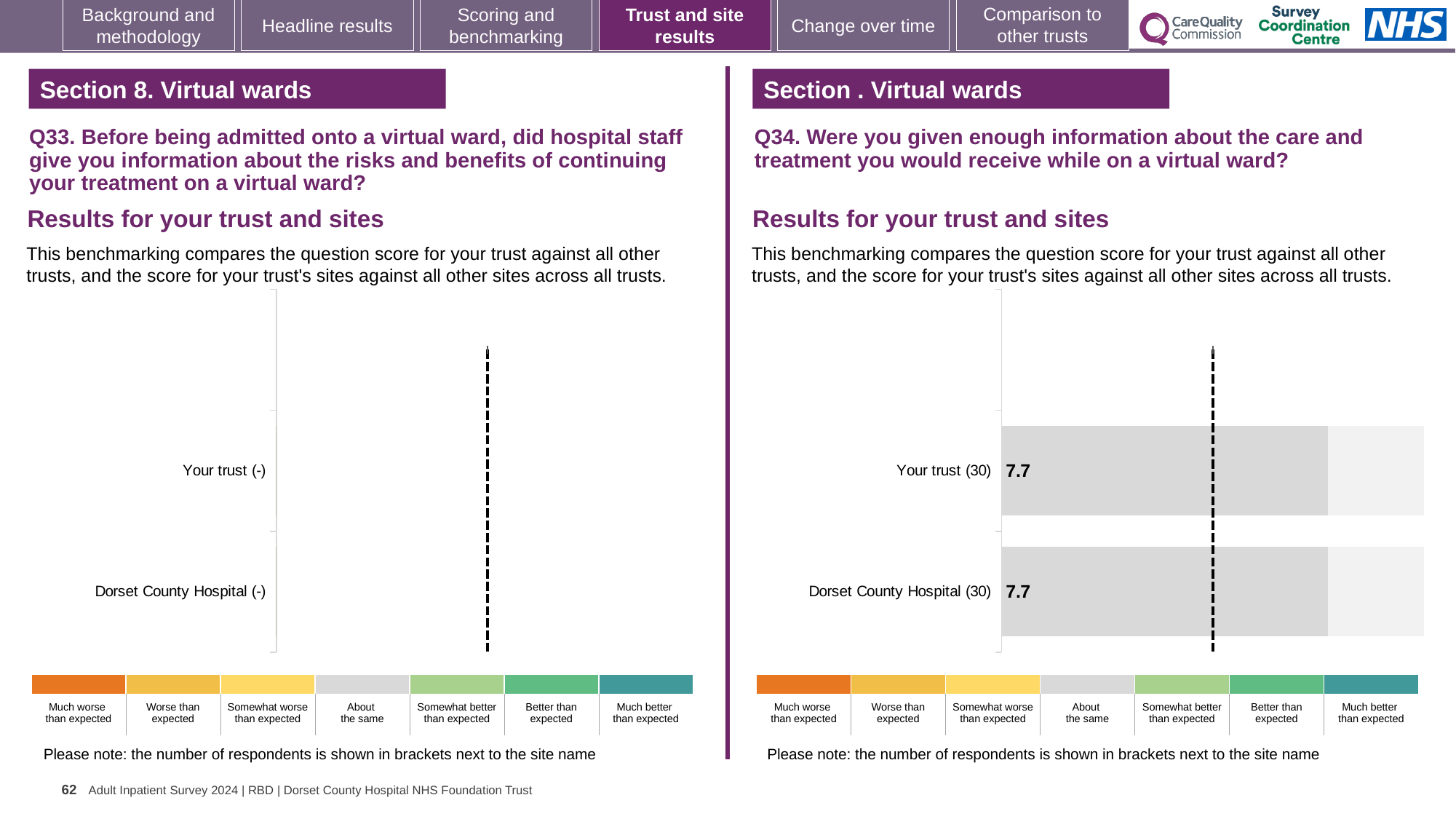
On the Q33 chart on the left, how many category labels are listed on the axis? 2 On the Q34 chart on the right, what is the difference between the values for Your trust and Dorset County Hospital? 0 What kind of chart is the Q34 chart on the right? Bar chart On the Q34 chart on the right, are the values for Your trust and Dorset County Hospital the same? Yes On the Q34 chart on the right, how many respondents are shown in brackets for Dorset County Hospital? 30 How many colour bands does the key below the Q34 chart on the right show? 7 On the Q34 chart on the right, what is the value shown for Dorset County Hospital (30)? 7.7 On the Q34 chart on the right, what is the value shown for Your trust (30)? 7.7 On the Q34 chart on the right, how many respondents are shown in brackets for Your trust? 30 On the Q33 chart on the left, what is shown in brackets next to Your trust? - On the Q34 chart on the right, how many categories are plotted? 2